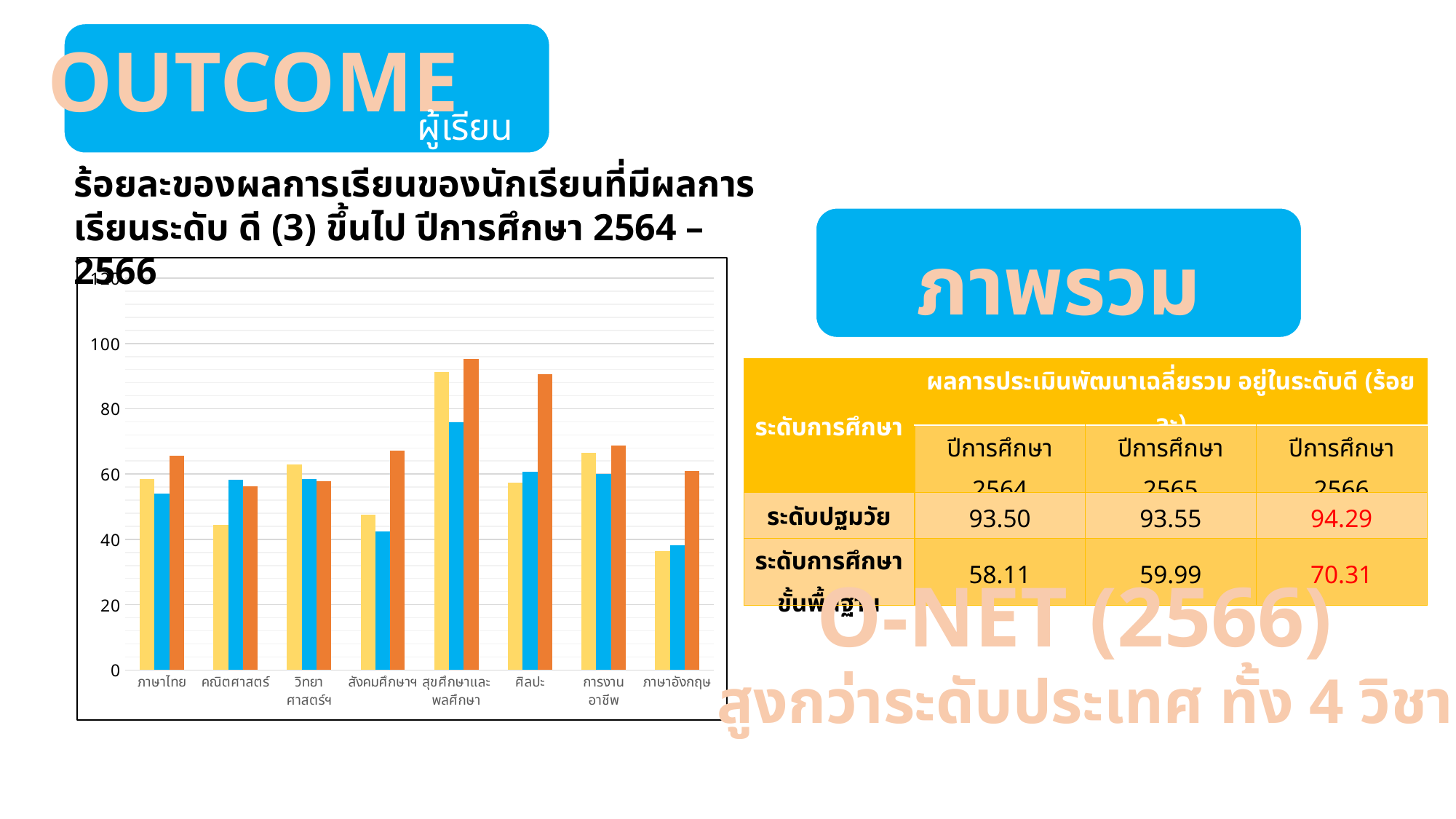
Is the yellow bar for ภาษาอังกฤษ greater or less than 40? less What kind of chart is shown on the left of the slide? bar chart Is the orange bar for ศิลปะ greater or less than 80? greater Is the orange bar for สุขศึกษาและพลศึกษา greater or less than 80? greater Which is larger in the bar chart: the yellow bar for ภาษาไทย or the yellow bar for สังคมศึกษาฯ? ภาษาไทย In the bar chart, which category has the shortest blue bar? ภาษาอังกฤษ In the bar chart, which category has the shortest yellow bar? ภาษาอังกฤษ How many subject categories are shown on the x axis of the bar chart? 8 How many differently coloured bars are shown for each category in the bar chart? 3 In the bar chart, which category has the tallest orange bar? สุขศึกษาและพลศึกษา Which is larger in the bar chart: the orange bar for ศิลปะ or the orange bar for ภาษาอังกฤษ? ศิลปะ